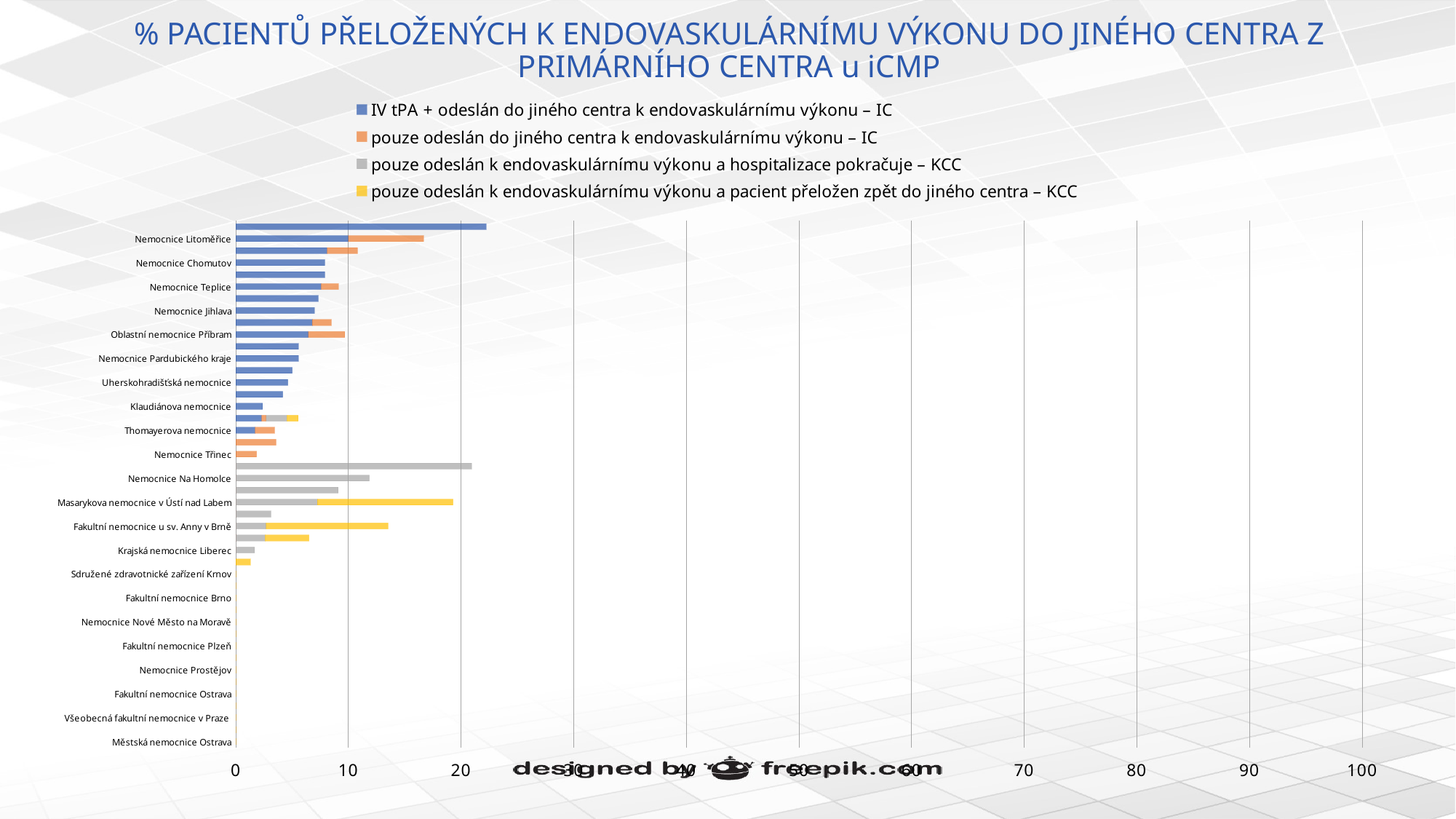
What is the highest value shown on the horizontal axis? 100 Does any bar in the chart reach a value greater than 50? No How many category labels are shown on the vertical axis? 22 Is the longest bar in the chart greater or less than 20? greater Is the longest grey bar greater or less than 30? less What kind of chart is shown on the slide? Bar chart How many series does the legend list? 4 What is the title of the chart? % PACIENTŮ PŘELOŽENÝCH K ENDOVASKULÁRNÍMU VÝKONU DO JINÉHO CENTRA Z PRIMÁRNÍHO CENTRA u iCMP Which series is shown in yellow in the legend? pouze odeslán k endovaskulárnímu výkonu a pacient přeložen zpět do jiného centra – KCC